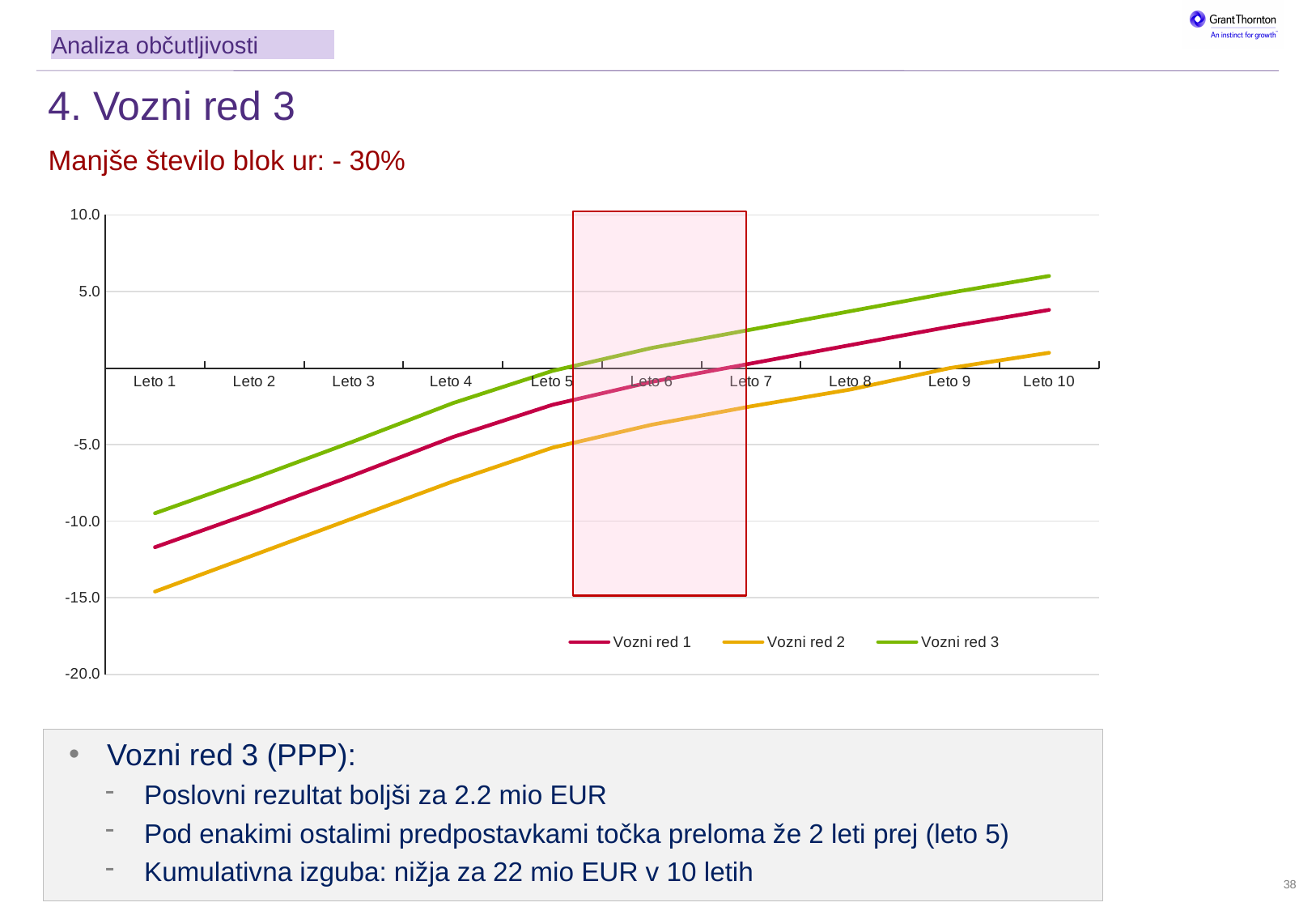
Which series has the highest value at Leto 10? Vozni red 3 Is the value for Vozni red 3 at Leto 10 greater or less than 5.0? greater What colour is the Vozni red 2 line in the chart? orange Is the value for Vozni red 1 at Leto 5 greater or less than -5.0? greater How many series does the chart legend list? 3 Do the values of the Vozni red 3 line rise or fall from Leto 1 to Leto 10? rise What kind of chart is shown on the slide? line chart Is the value for Vozni red 2 at Leto 1 greater or less than -10.0? less Which series has the lowest value at Leto 1? Vozni red 2 How many years (categories) are shown on the x axis of the chart? 10 At Leto 1, which is larger: the value for Vozni red 3 or the value for Vozni red 2? Vozni red 3